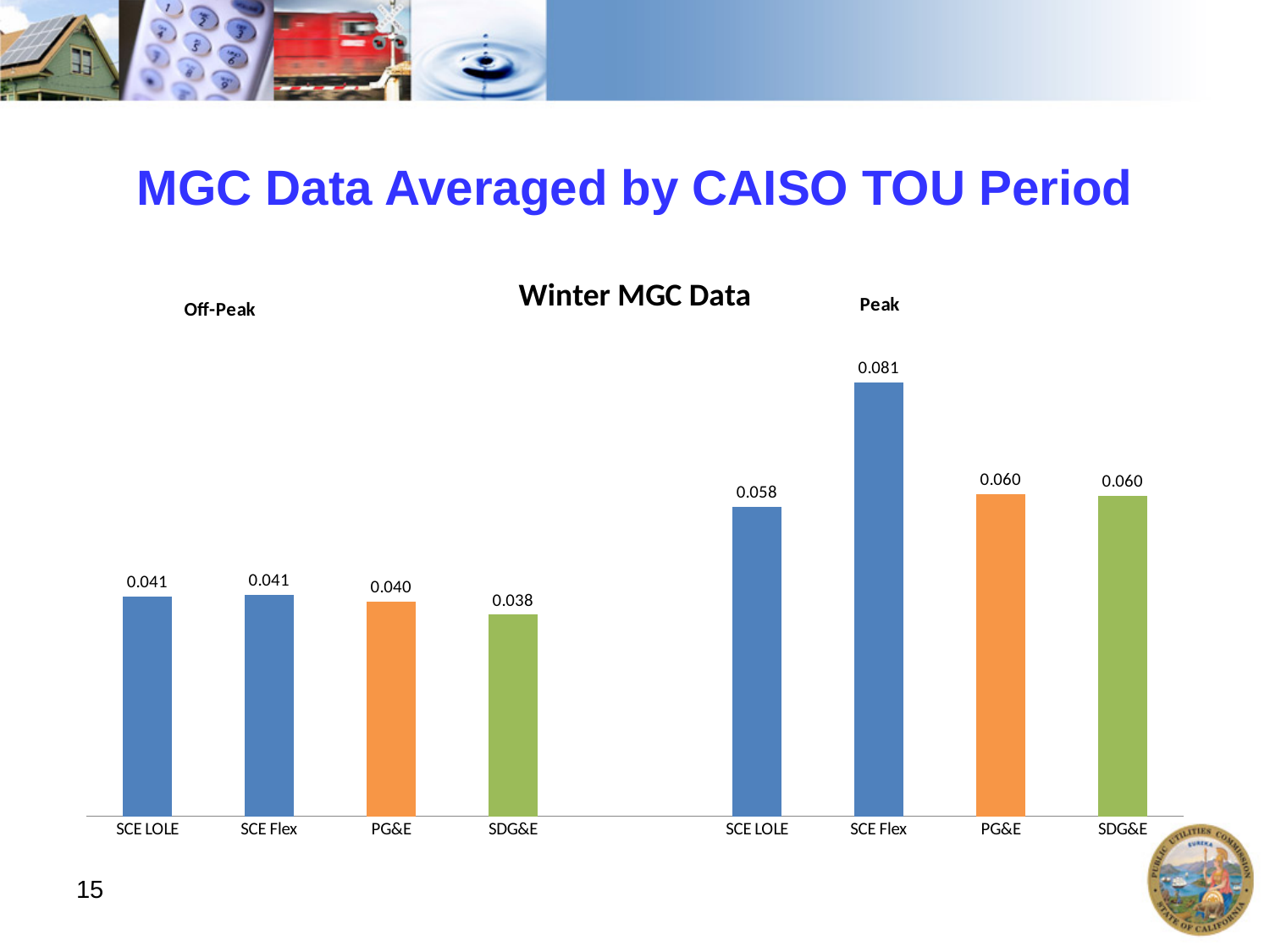
What is the title of the chart? Winter MGC Data What is the Off-Peak value for SCE LOLE? 0.041 What is the difference between the Peak value for SCE Flex and the Peak value for SCE LOLE? 0.023 What is the Off-Peak value for SDG&E? 0.038 What type of chart is shown on the slide? bar chart What is the Peak value for SCE Flex? 0.081 What is the difference between the Peak and Off-Peak values for SDG&E? 0.022 Which category has the lowest value in the Off-Peak group? SDG&E Which category has the highest value in the Peak group? SCE Flex How many bars are plotted in the Off-Peak group? 4 Which is larger: the Peak value for SCE LOLE or the Peak value for PG&E? PG&E What is the Peak value for PG&E? 0.060